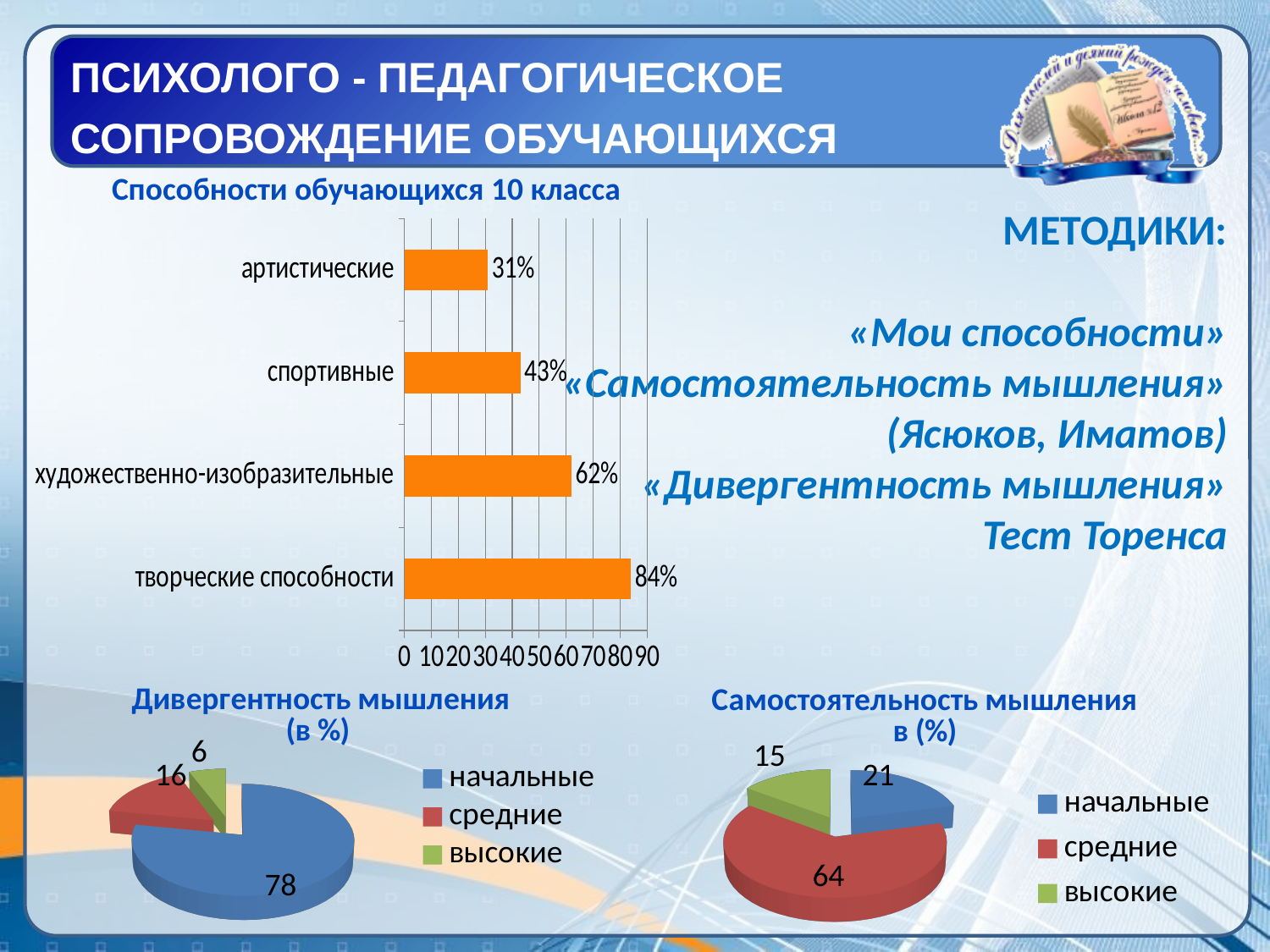
In the chart 'Способности обучающихся 10 класса', what is the value for 'спортивные'? 43% In the pie chart 'Дивергентность мышления (в %)', which category has the smallest slice? высокие In the pie chart 'Дивергентность мышления (в %)', what is the value for 'начальные'? 78 What colour are the bars in the chart 'Способности обучающихся 10 класса'? orange In the pie chart 'Самостоятельность мышления в (%)', which is larger: 'начальные' or 'высокие'? начальные In the chart 'Способности обучающихся 10 класса', how many categories are shown? 4 What type of chart is 'Способности обучающихся 10 класса'? bar chart How many entries does the legend of the pie chart 'Самостоятельность мышления в (%)' list? 3 In the pie chart 'Самостоятельность мышления в (%)', what is the value for 'средние'? 64 In the chart 'Способности обучающихся 10 класса', which category has the lowest value? артистические In the chart 'Способности обучающихся 10 класса', what is the difference between 'художественно-изобразительные' and 'артистические'? 31% In the chart 'Способности обучающихся 10 класса', what is the value for 'творческие способности'? 84%